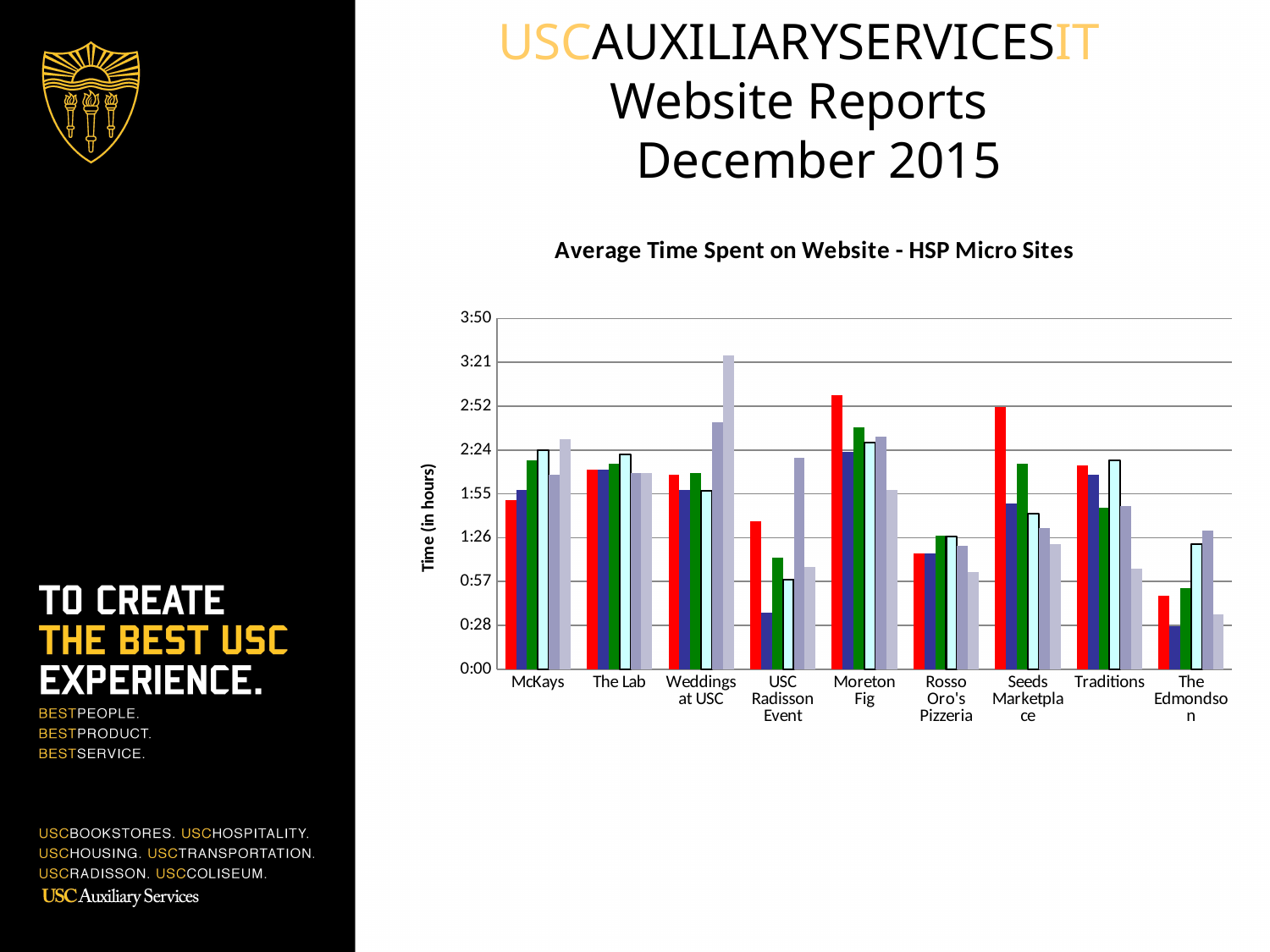
Which micro site has the shortest red bar in the chart? The Edmondson How many micro sites (categories) are shown along the x axis of the chart? 9 Is the tallest bar for Weddings at USC greater or less than 2:52? greater Is the red bar for Rosso Oro's Pizzeria greater or less than 1:26? less Is the red bar for The Edmondson greater or less than 0:57? less Which micro site has the tallest red bar in the chart? Moreton Fig What is the title of the chart? Average Time Spent on Website - HSP Micro Sites Which micro site has the tallest bar of any colour in the chart? Weddings at USC Which has the larger red bar, Moreton Fig or Rosso Oro's Pizzeria? Moreton Fig What is the label of the vertical axis of the chart? Time (in hours) What kind of chart is shown on the slide? Bar chart